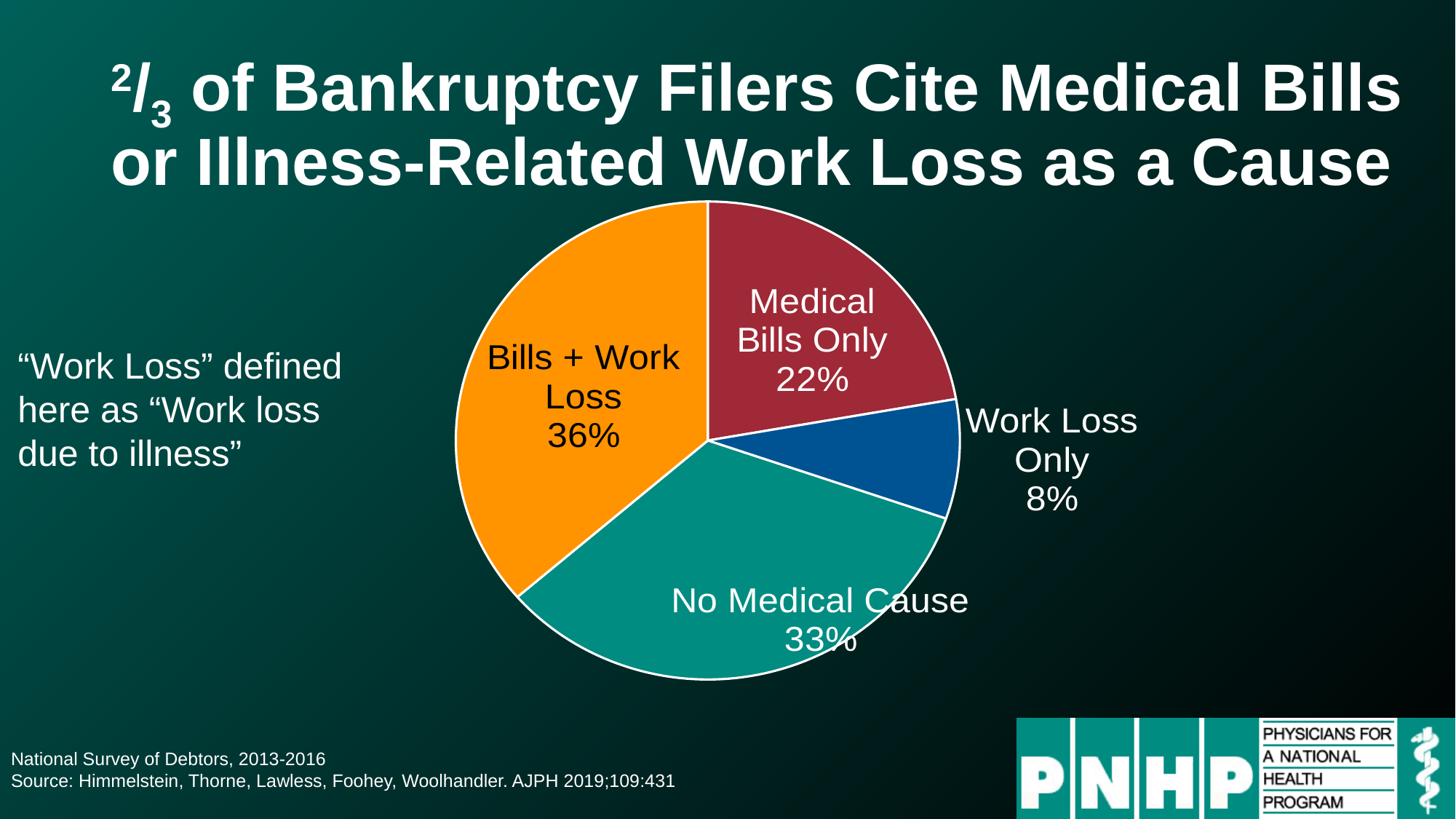
Which slice of the pie is the largest? Bills + Work Loss What percentage is shown for "Medical Bills Only"? 22% Which slice of the pie is the smallest? Work Loss Only How many slices does the pie chart have? 4 Which is larger, the share for "Medical Bills Only" or the share for "Work Loss Only"? Medical Bills Only What type of chart is shown on the slide? Pie chart What percentage is shown for "Work Loss Only"? 8% What percentage is shown for "No Medical Cause"? 33% What share of the pie is labelled "Bills + Work Loss"? 36% What is the difference in percentage points between "Medical Bills Only" and "Work Loss Only"? 14 percentage points What colour is the "No Medical Cause" slice? Teal What is the difference in percentage points between "Bills + Work Loss" and "No Medical Cause"? 3 percentage points